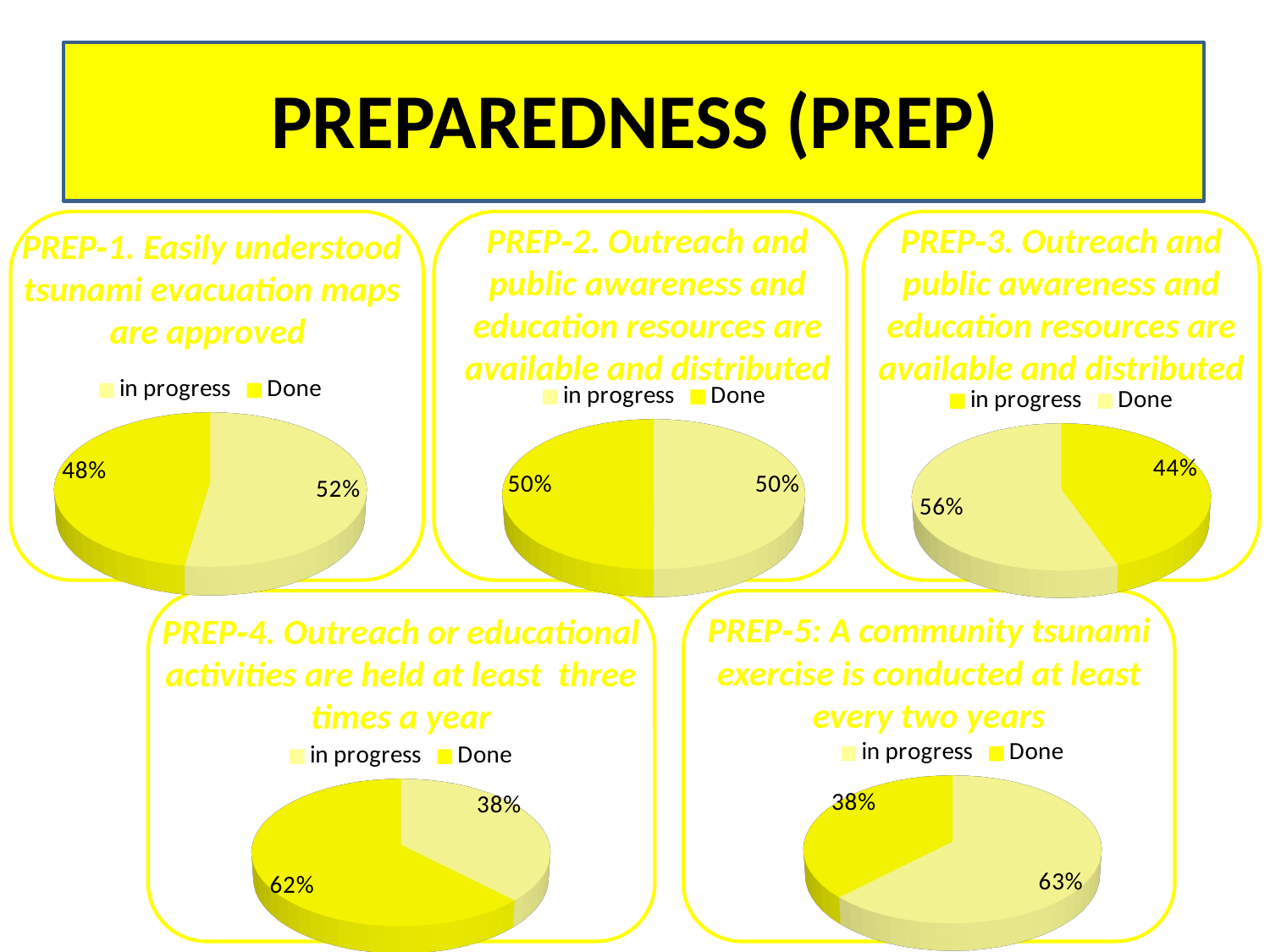
In the PREP-3 chart, what percentage is shown for the 'in progress' slice? 44% In the PREP-1 chart, what percentage is shown for the 'in progress' slice? 52% How many entries does the legend of the PREP-2 chart list? 2 How many pie charts are shown on the slide? 5 In the PREP-5 chart, what percentage is shown for the 'in progress' slice? 63% In the PREP-3 chart, what percentage is shown for the 'Done' slice? 56% In the PREP-4 chart, which slice is larger, 'Done' or 'in progress'? Done In the PREP-5 chart, what is the difference between the 'in progress' and 'Done' percentages? 25% In the PREP-1 chart, what percentage is shown for the 'Done' slice? 48% In the PREP-2 chart, what percentage is shown for the 'Done' slice? 50% In the PREP-4 chart, what percentage is shown for the 'Done' slice? 62% What kind of chart is used for PREP-1? pie chart